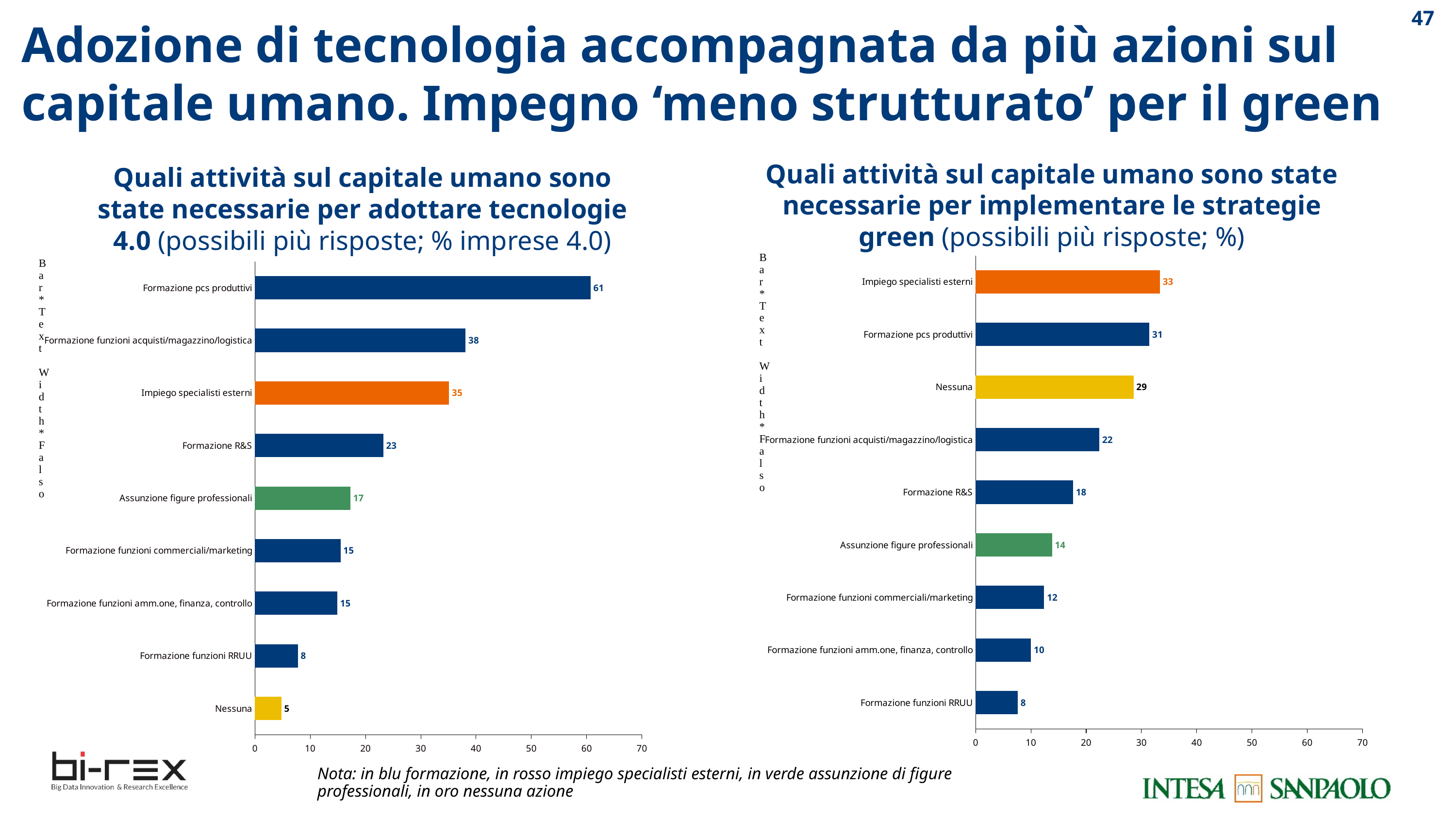
In the left chart (tecnologie 4.0), what is the difference between Formazione pcs produttivi and Formazione funzioni acquisti/magazzino/logistica? 23 According to the note on the slide, what colour represents 'nessuna azione'? Oro (gold) How many categories are shown in the left chart (tecnologie 4.0)? 9 What kind of chart is the right chart (strategie green)? Bar chart In the right chart (strategie green), what is the difference between Impiego specialisti esterni and Formazione funzioni RRUU? 25 In the left chart (tecnologie 4.0), what is the value for Assunzione figure professionali? 17 In the right chart (strategie green), which category has the highest value? Impiego specialisti esterni In the left chart (tecnologie 4.0), which is larger: Impiego specialisti esterni or Formazione R&S? Impiego specialisti esterni In the right chart (strategie green), what is the value for Nessuna? 29 In the right chart (strategie green), is the value for Formazione funzioni acquisti/magazzino/logistica greater or less than 20? greater In the left chart (tecnologie 4.0), what is the value for Formazione pcs produttivi? 61 In the left chart (tecnologie 4.0), which category has the lowest value? Nessuna